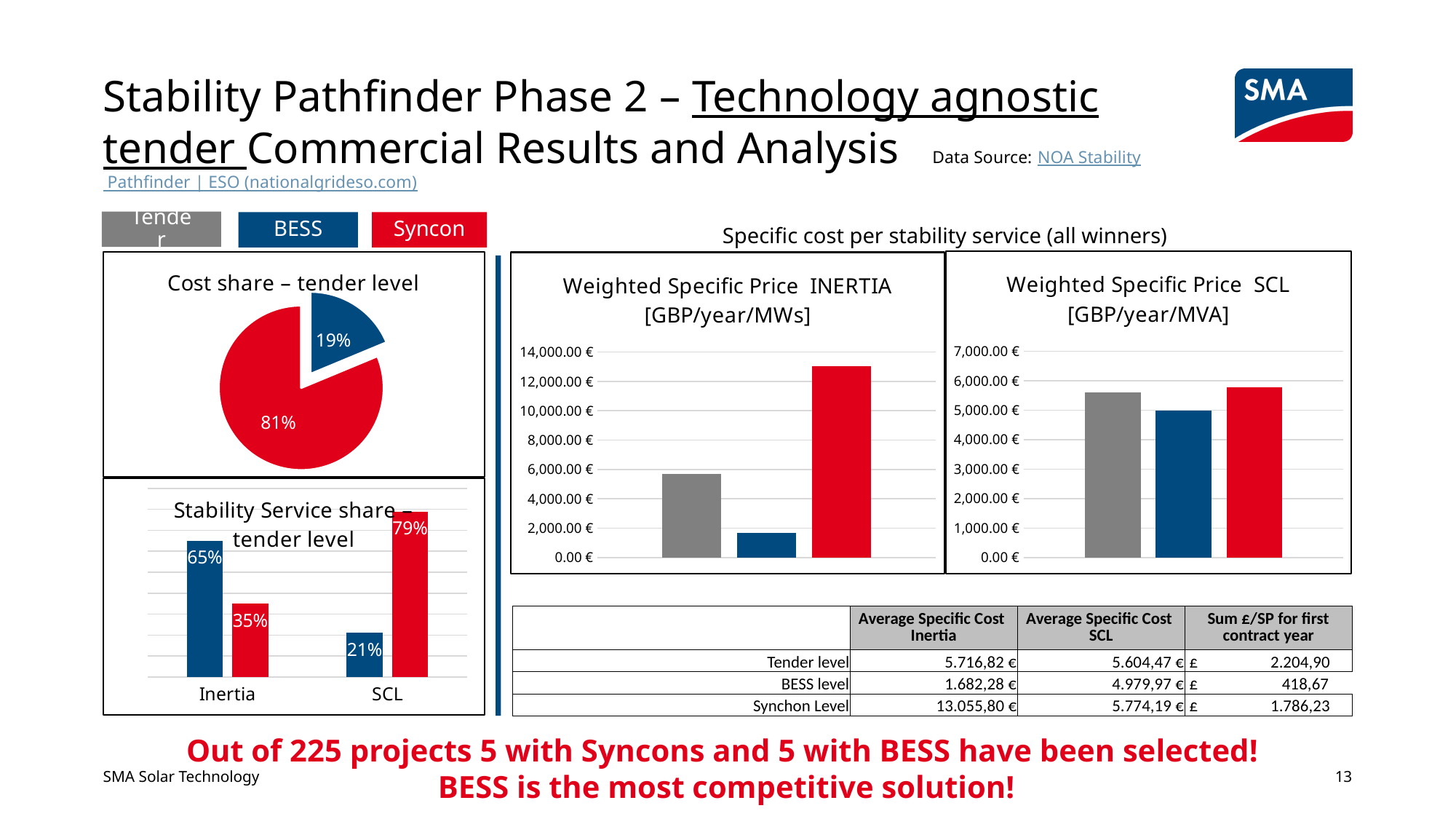
In the 'Cost share – tender level' pie chart, which slice is the largest? Syncon (81%) In the 'Stability Service share – tender level' chart, which is larger for SCL, BESS or Syncon? Syncon In the 'Stability Service share – tender level' chart, what is the difference between the BESS and Syncon values for Inertia? 30 percentage points How many categories are shown on the x axis of the 'Stability Service share – tender level' chart? 2 In the 'Weighted Specific Price INERTIA' chart, is the value for Syncon greater or less than 12,000.00 €? greater In the 'Cost share – tender level' pie chart, what share does the BESS (blue) slice have? 19% What kind of chart is 'Cost share – tender level'? pie chart In the 'Stability Service share – tender level' chart, what is the BESS value for Inertia? 65% In the 'Weighted Specific Price SCL' chart, which bar is the lowest? BESS In the 'Stability Service share – tender level' chart, what is the Syncon value for SCL? 79% In the 'Weighted Specific Price INERTIA' chart, is the value for BESS greater or less than 2,000.00 €? less In the 'Weighted Specific Price INERTIA' chart, which bar is the highest? Syncon